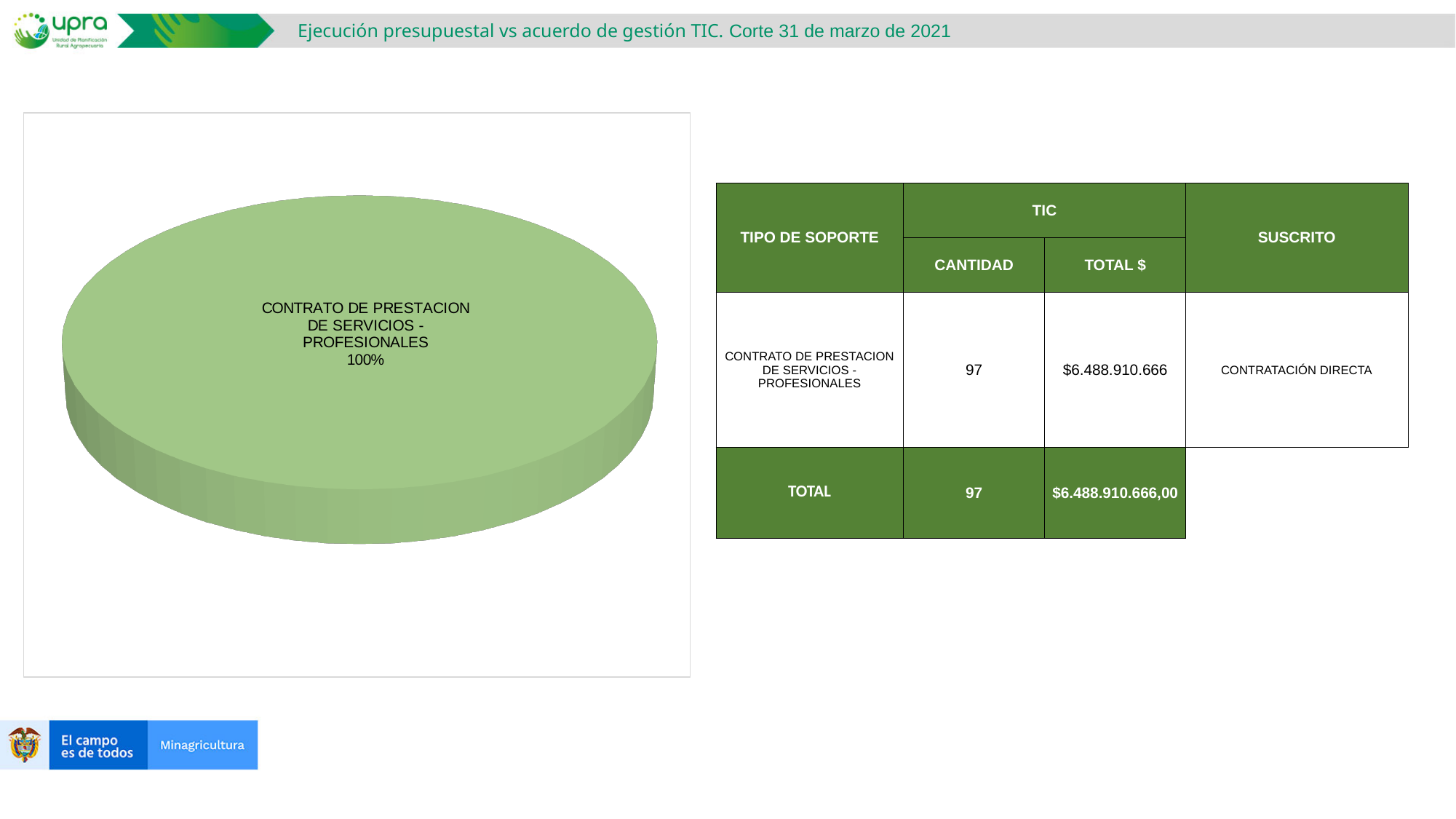
What is the percentage label printed on the pie chart slice? 100% What kind of chart is shown on the slide? Pie chart Which category is the largest slice of the pie chart? CONTRATO DE PRESTACION DE SERVICIOS - PROFESIONALES What is the name of the only category shown in the pie chart? CONTRATO DE PRESTACION DE SERVICIOS - PROFESIONALES What share of the pie does the slice CONTRATO DE PRESTACION DE SERVICIOS - PROFESIONALES represent? 100% How many slices does the pie chart have? 1 Is the pie chart drawn in 3D or flat 2D? 3D What colour is the slice of the pie chart? Green